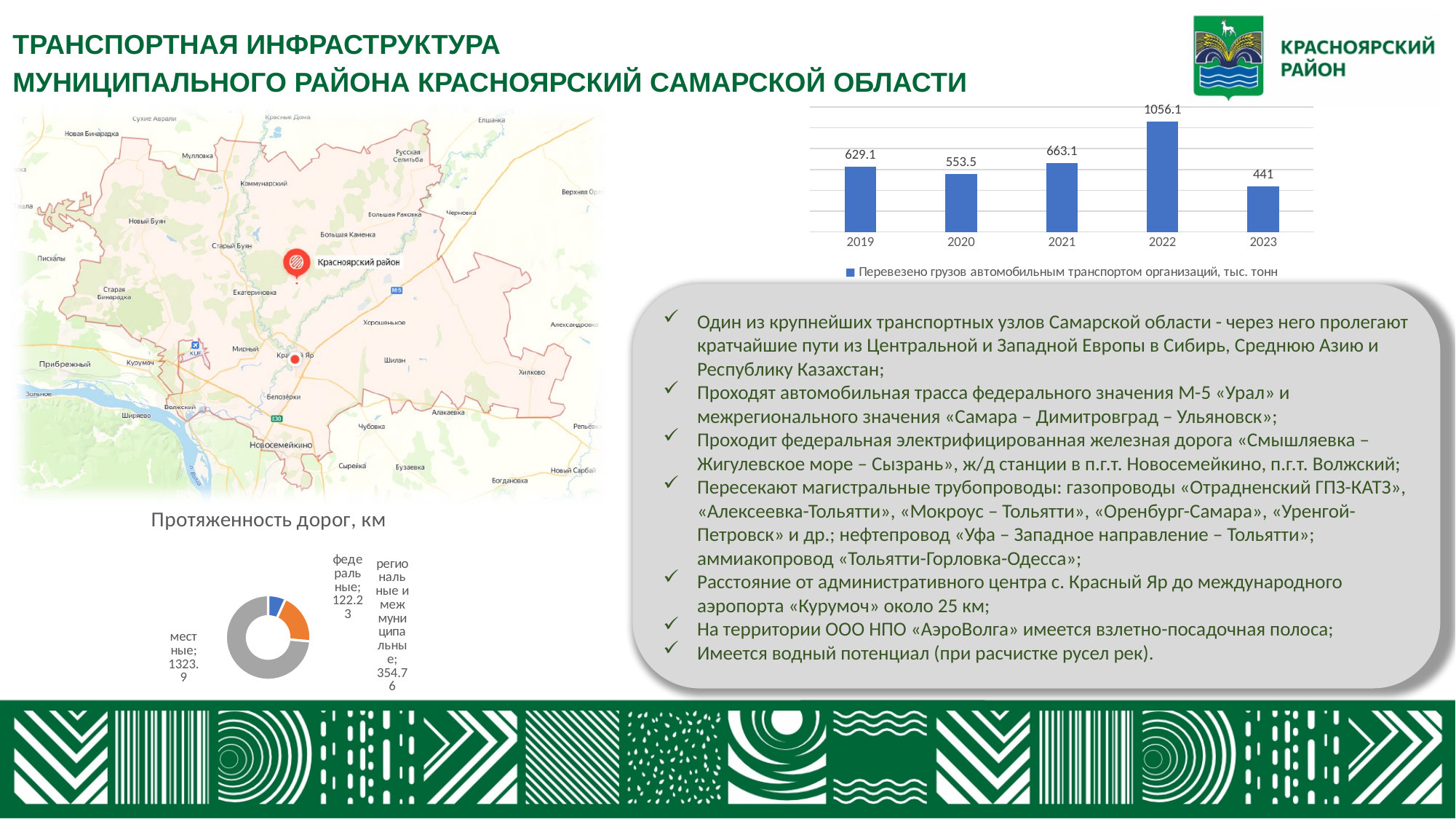
What kind of chart is the chart at the top right of the slide? Bar chart In the bar chart at the top right, what value is shown for 2020? 553.5 In the bar chart at the top right, which is larger, the value for 2019 or the value for 2021? 2021 What does the legend of the bar chart at the top right say? Перевезено грузов автомобильным транспортом организаций, тыс. тонн How many years are shown in the bar chart at the top right? 5 In the bar chart at the top right, which year has the lowest value? 2023 In the chart 'Протяженность дорог, км', which category has the smallest value? федеральные In the chart 'Протяженность дорог, км', what is the value for местные roads? 1323.9 In the bar chart at the top right, what value is shown for 2022? 1056.1 What kind of chart is 'Протяженность дорог, км'? Doughnut chart In the bar chart at the top right, what is the difference between the values for 2022 and 2023? 615.1 In the bar chart at the top right, which year has the highest value? 2022